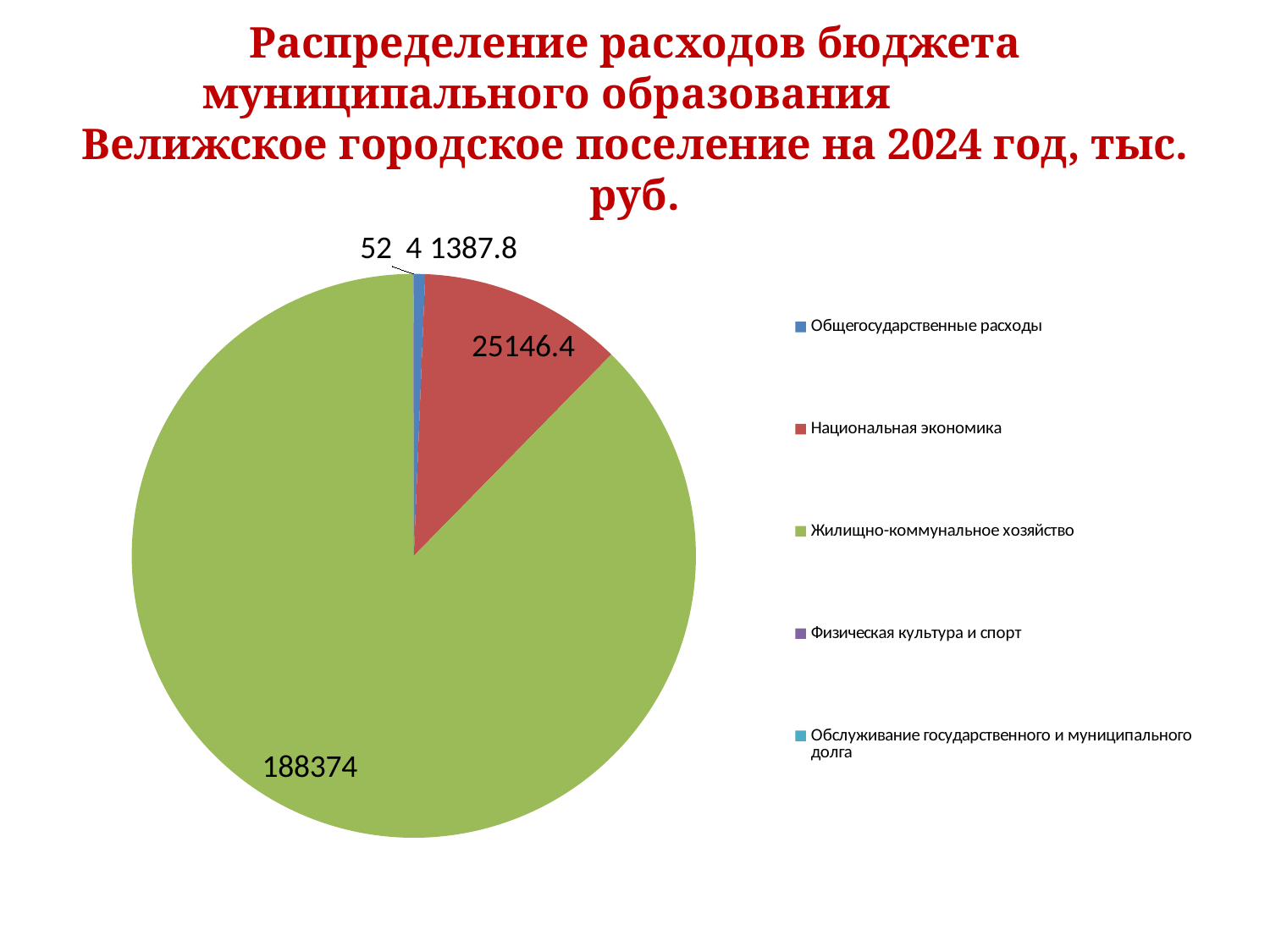
For which year does the chart title say the budget expenditures are distributed? 2024 What is the total of all the values labelled on the pie chart? 214964.2 Which is larger: the value for Национальная экономика or the value for Общегосударственные расходы? Национальная экономика How many categories does the legend of the pie chart list? 5 What colour is the slice for Национальная экономика? Red What is the value shown for Общегосударственные расходы? 1387.8 What is the value shown for Жилищно-коммунальное хозяйство? 188374 What is the value shown for Национальная экономика? 25146.4 What kind of chart is shown on the slide? Pie chart What is the difference between the values for Жилищно-коммунальное хозяйство and Национальная экономика? 163227.6 Which category has the largest slice of the pie? Жилищно-коммунальное хозяйство